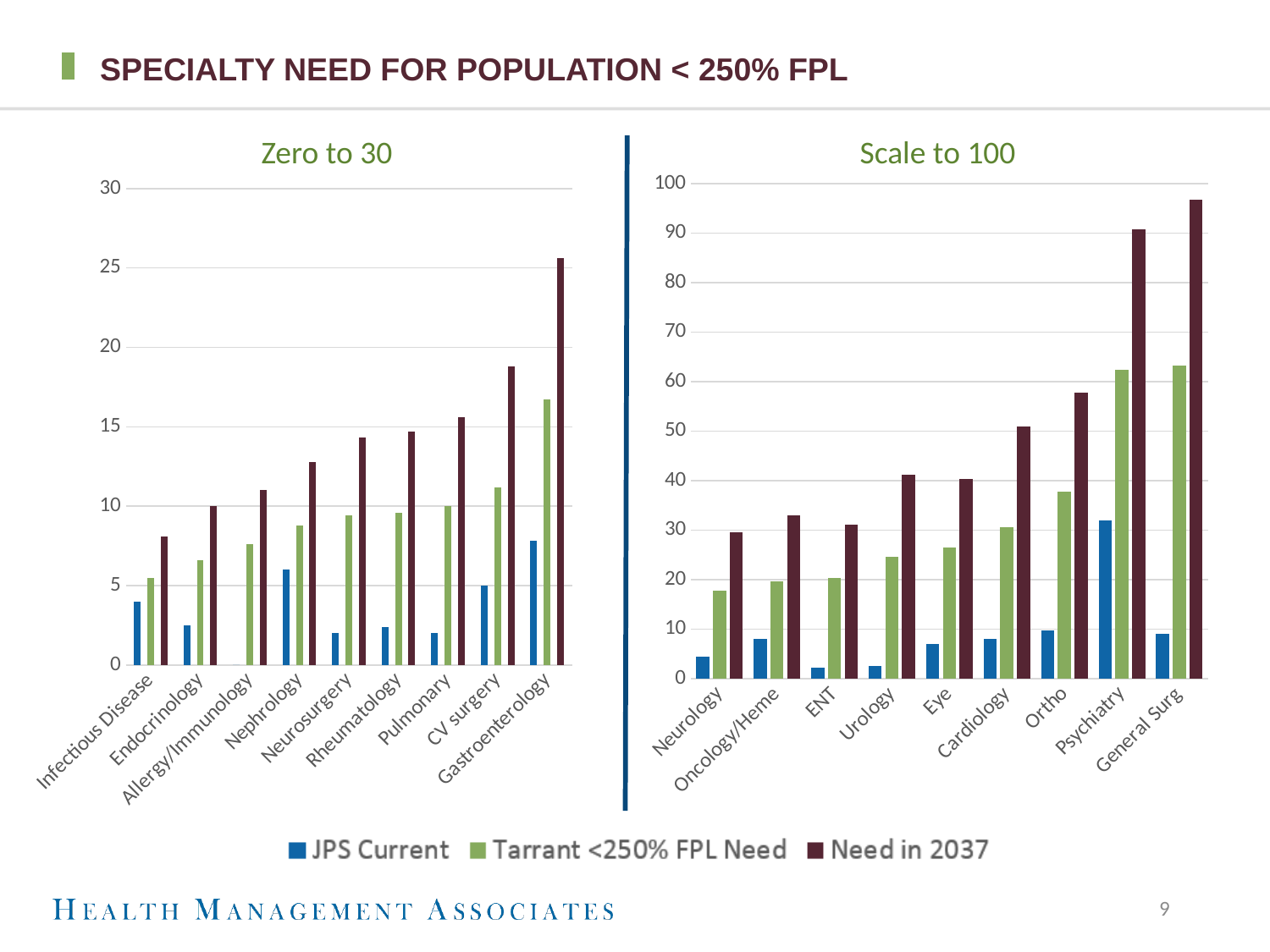
On the "Zero to 30" chart, which specialty has the lowest JPS Current value? Allergy/Immunology On the "Zero to 30" chart, do the Need in 2037 values rise or fall from Infectious Disease to Gastroenterology? rise On the "Scale to 100" chart, is the JPS Current value for Psychiatry greater or less than 20? greater Which series is shown in green in the legend? Tarrant <250% FPL Need On the "Zero to 30" chart, is the Need in 2037 value for Gastroenterology greater or less than 20? greater What kind of chart is the "Zero to 30" chart? bar chart On the "Scale to 100" chart, which has the larger Tarrant <250% FPL Need value, Ortho or Cardiology? Ortho On the "Zero to 30" chart, which specialty has the highest Need in 2037 value? Gastroenterology How many specialties are shown on the "Zero to 30" chart? 9 On the "Scale to 100" chart, which specialty has the highest JPS Current value? Psychiatry On the "Scale to 100" chart, is the Need in 2037 value for Psychiatry greater or less than 80? greater How many series does the legend list? 3